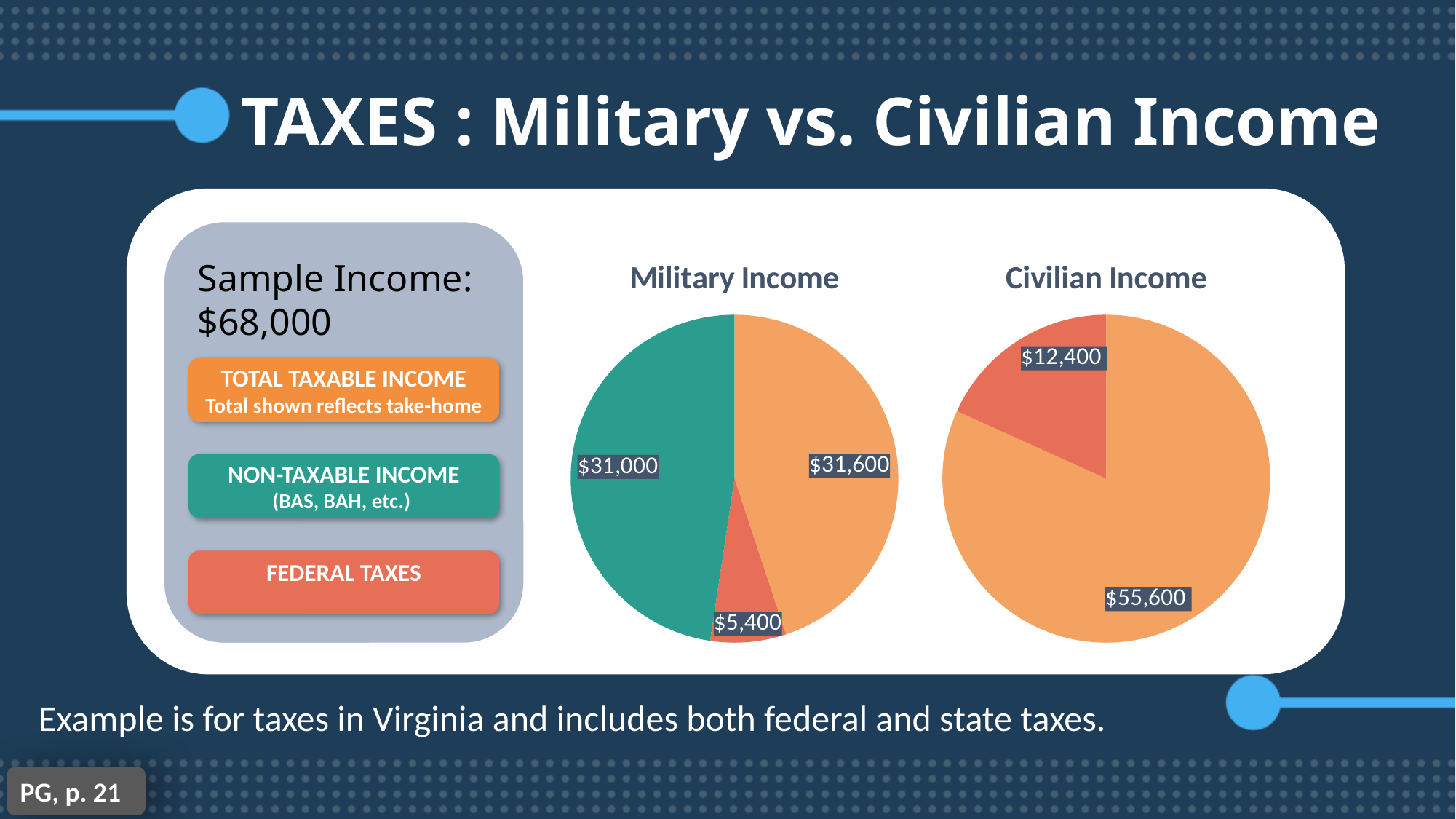
In the Military Income chart, what is the value of the Federal Taxes slice? $5,400 In the Military Income chart, what is the value of the Total Taxable Income slice? $31,600 In the Military Income chart, what is the value of the Non-Taxable Income slice? $31,000 In the Civilian Income chart, what is the value of the Total Taxable Income slice? $55,600 In the Civilian Income chart, which slice is the largest? Total Taxable Income Which is larger: Total Taxable Income in the Civilian Income chart or Total Taxable Income in the Military Income chart? Civilian Income In the Military Income chart, which slice is the smallest? Federal Taxes What is the difference between Federal Taxes in the Civilian Income chart and Federal Taxes in the Military Income chart? $7,000 How many slices does the Civilian Income pie chart have? 2 What type of charts are shown on the slide? Pie charts In the Civilian Income chart, what is the value of the Federal Taxes slice? $12,400 How many slices does the Military Income pie chart have? 3